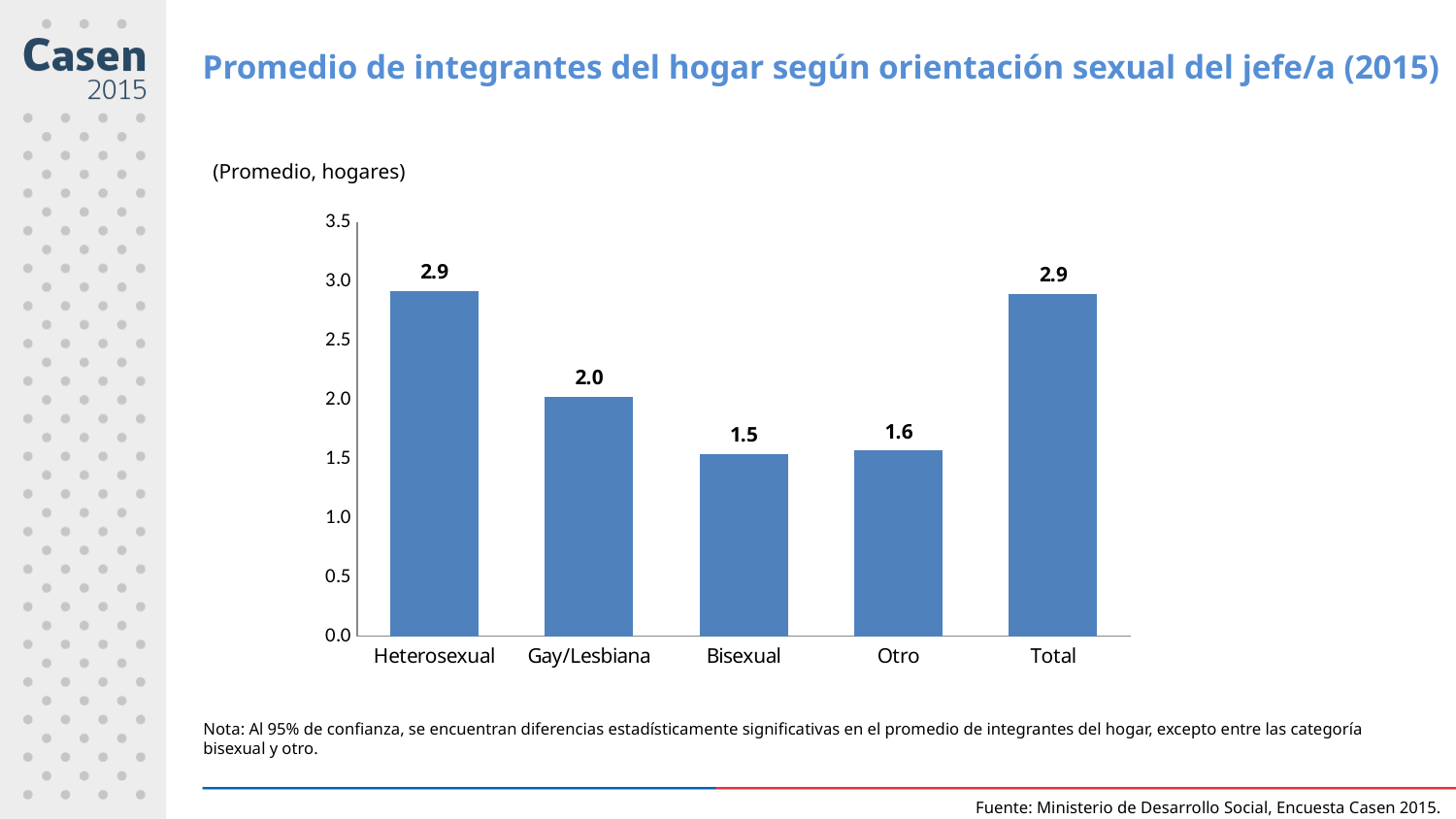
Which is larger, the value for Gay/Lesbiana or the value for Otro? Gay/Lesbiana What is the value for Otro? 1.6 What is the difference between the values for Otro and Bisexual? 0.1 What is the value for Bisexual? 1.5 Which category has the lowest value? Bisexual What is the value for Heterosexual? 2.9 Is the value for Gay/Lesbiana greater or less than 2.5? less What is the value for Total? 2.9 What is the difference between the values for Heterosexual and Gay/Lesbiana? 0.9 How many categories are shown on the x axis? 5 What kind of chart is shown on the slide? bar chart What is the value for Gay/Lesbiana? 2.0